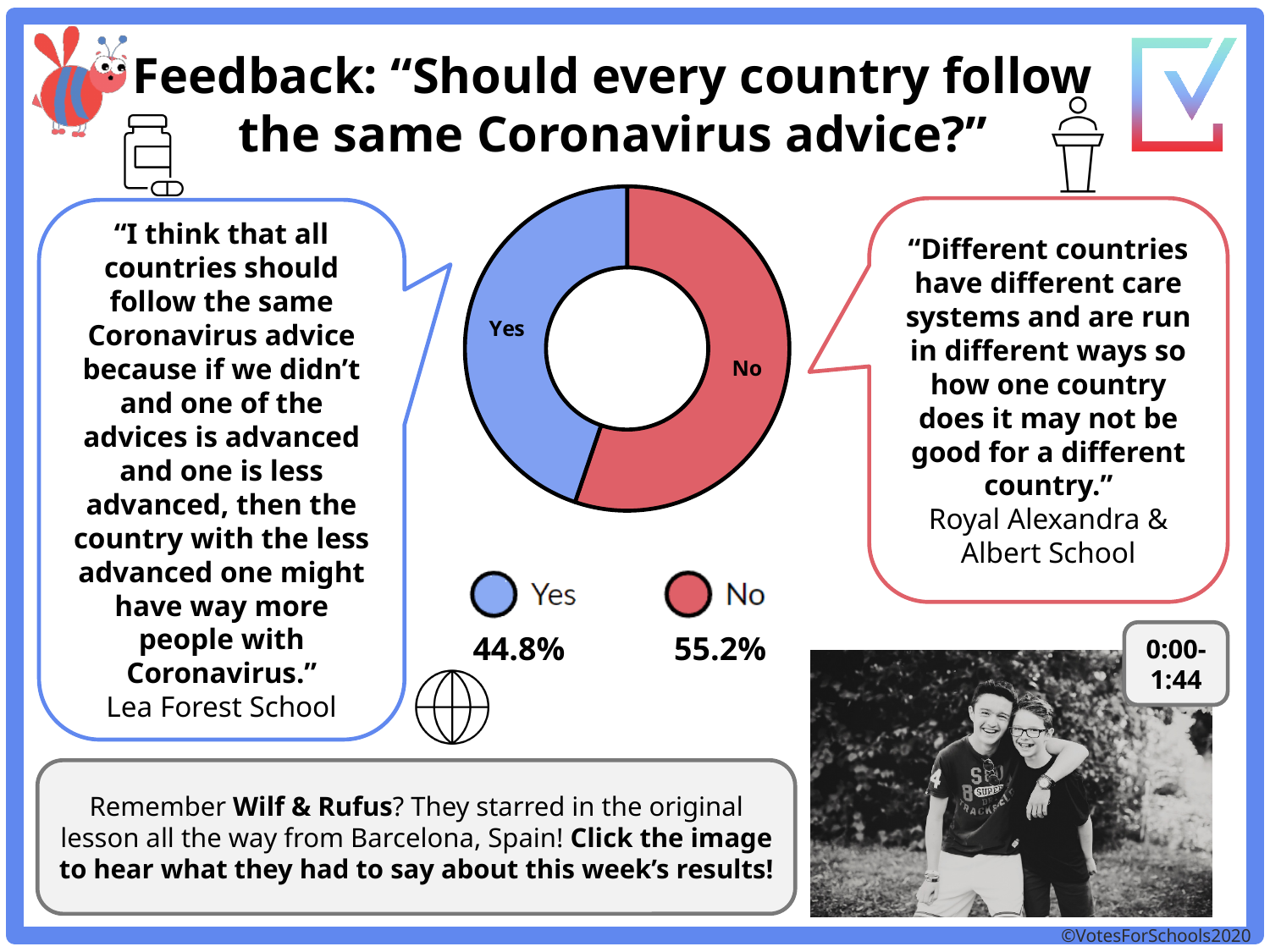
What colour represents the Yes slice? Blue Which response received the smaller share? Yes What is the difference in percentage points between the No and Yes shares? 10.4 Which response received the larger share, Yes or No? No What percentage of respondents answered No? 55.2% What colour represents the No slice? Red How many entries does the legend list? 2 What is the total of the Yes and No percentages? 100% Is the share for Yes greater or less than 50%? less How many categories does the chart show? 2 What kind of chart is shown on the slide? Pie chart (doughnut) What percentage of respondents answered Yes? 44.8%